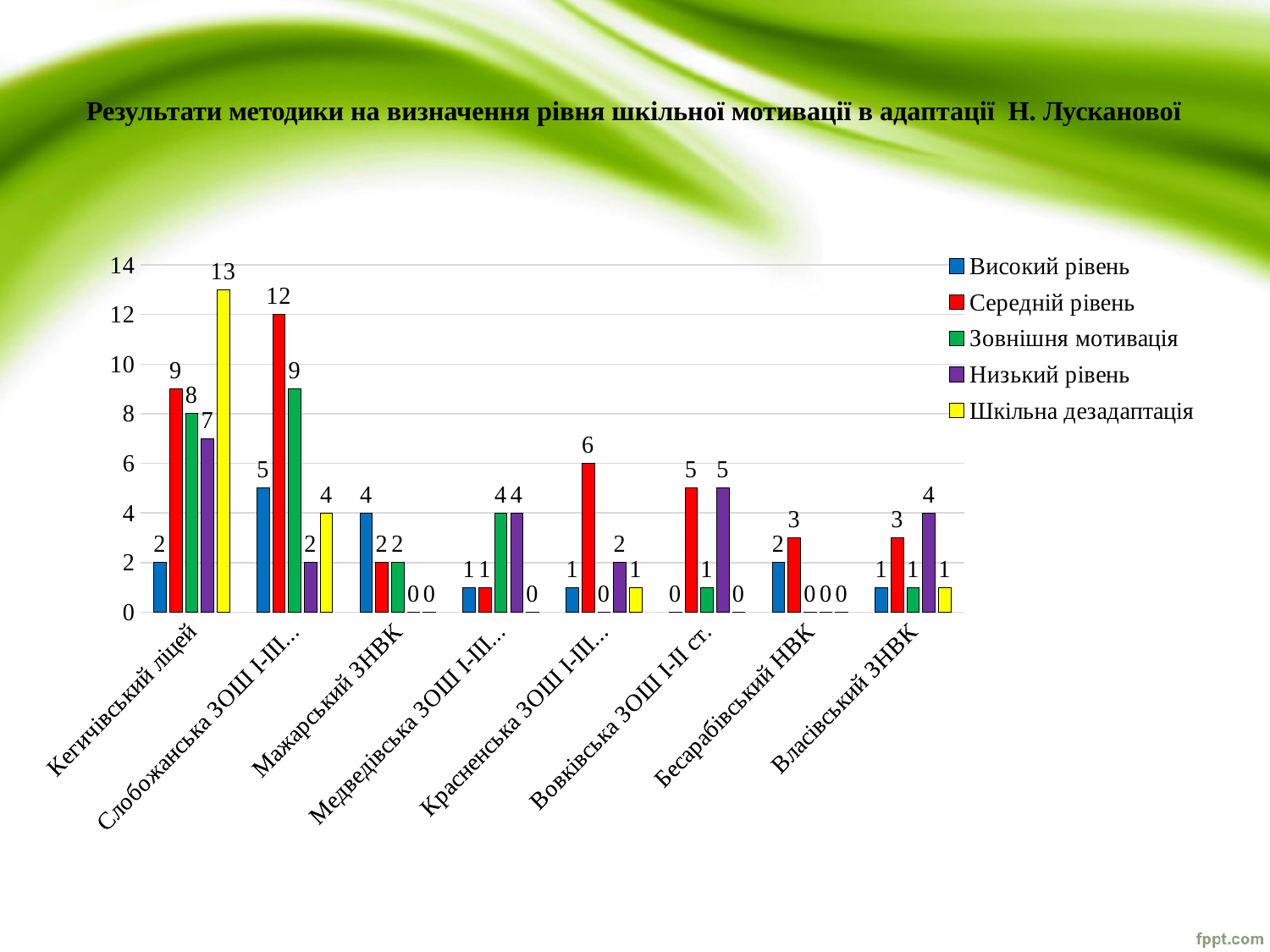
What kind of chart is shown on the slide? Bar chart Which colour represents Зовнішня мотивація in the legend? Green Which is larger for Красненська ЗОШ І-ІІІ...: Середній рівень or Низький рівень? Середній рівень Which category has the lowest value for Високий рівень? Вовківська ЗОШ І-ІІ ст. Which category has the highest value for Середній рівень? Слобожанська ЗОШ І-ІІІ... What is the value of Шкільна дезадаптація for Кегичівський ліцей? 13 What is the value of Низький рівень for Власівський ЗНВК? 4 How many series does the legend list? 5 What is the value of Високий рівень for Мажарський ЗНВК? 4 How many categories (schools) are shown on the x axis? 8 What is the difference between Шкільна дезадаптація and Високий рівень for Кегичівський ліцей? 11 What is the value of Середній рівень for Слобожанська ЗОШ І-ІІІ...? 12